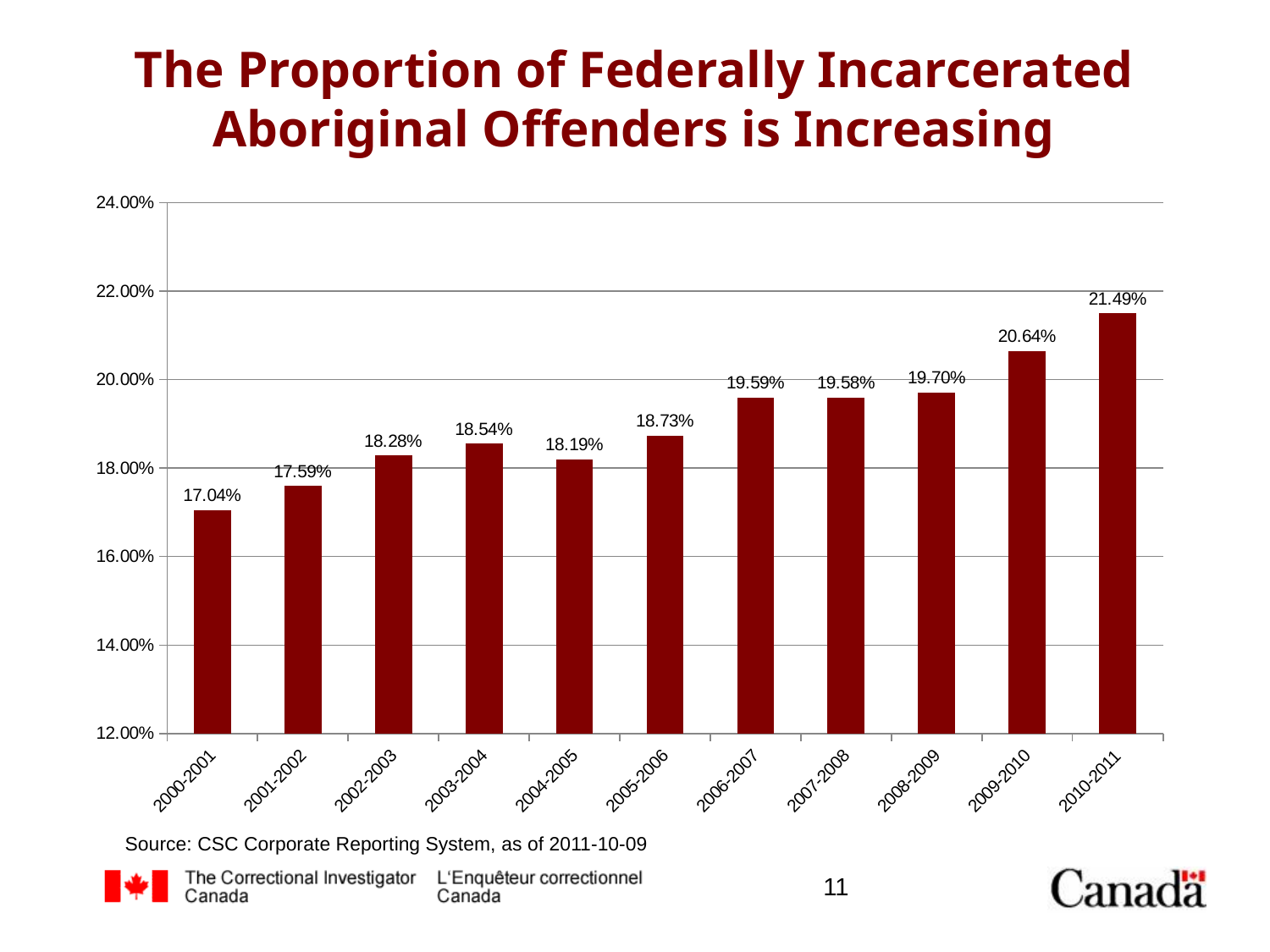
Do the values generally rise or fall from 2000-2001 to 2010-2011? rise Is the value for 2009-2010 greater or less than 20.00%? greater What is the value for 2010-2011? 21.49% How many fiscal years are shown on the x axis? 11 Which is larger, the value for 2003-2004 or the value for 2004-2005? 2003-2004 What is the value for 2004-2005? 18.19% Which fiscal year has the lowest proportion? 2000-2001 What is the value for 2000-2001? 17.04% Which fiscal year has the highest proportion? 2010-2011 What is the title of the slide? The Proportion of Federally Incarcerated Aboriginal Offenders is Increasing What is the difference between the values for 2010-2011 and 2000-2001? 4.45% What kind of chart is shown on the slide? bar chart